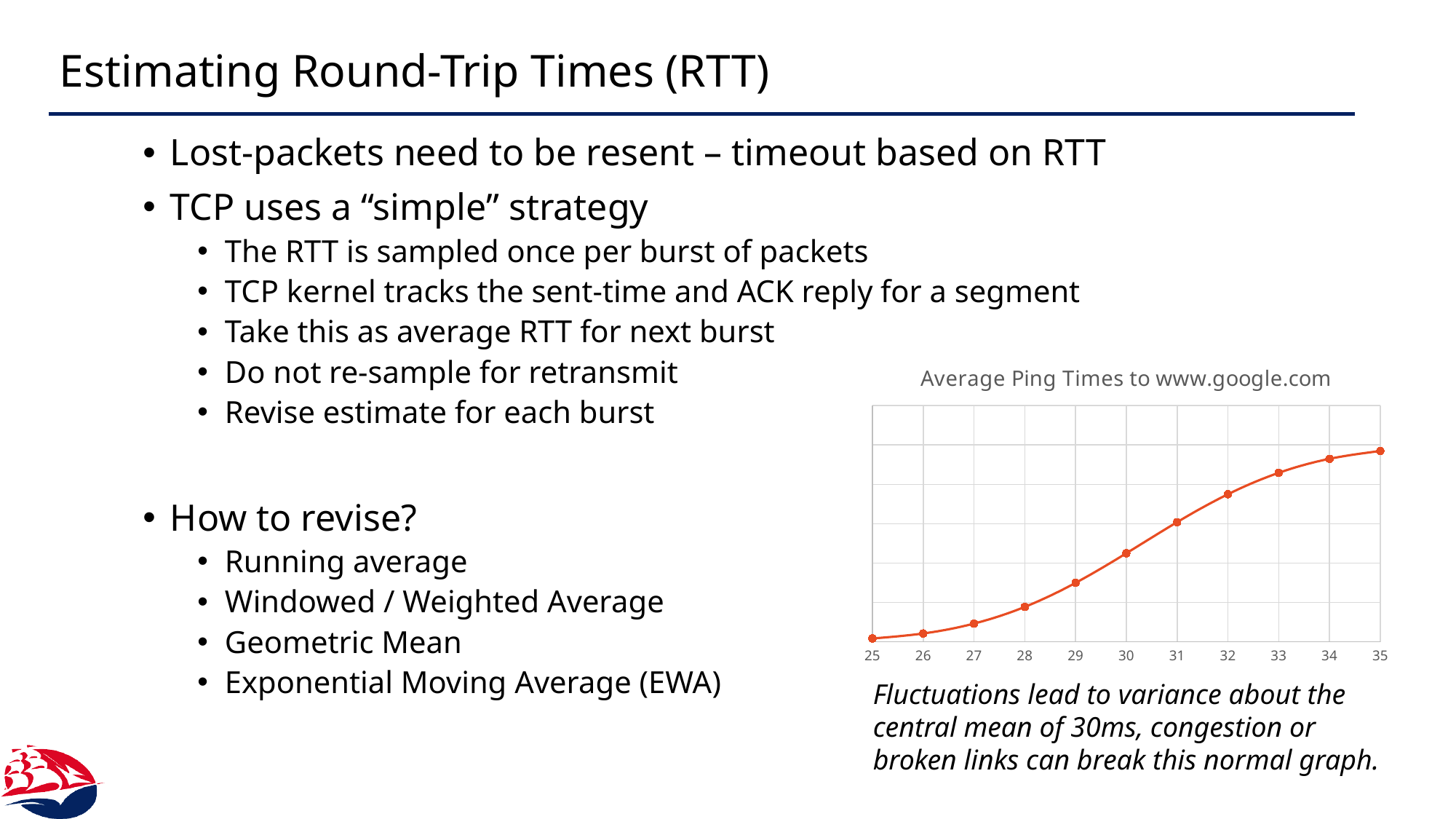
At which x-axis value does the line have its lowest point? 25 What is the first x-axis label shown on the chart? 25 Do the values in the chart rise or fall as the x axis goes from 25 to 35? Rise At which x-axis value does the line reach its highest point? 35 Which has the larger value in the chart, the point at 30 or the point at 26? 30 Which has the larger value in the chart, the point at 28 or the point at 32? 32 What kind of chart is shown on the slide? Line chart How many data points are plotted on the line in the chart? 11 Which has the smaller value in the chart, the point at 27 or the point at 33? 27 What is the title of the chart on the slide? Average Ping Times to www.google.com